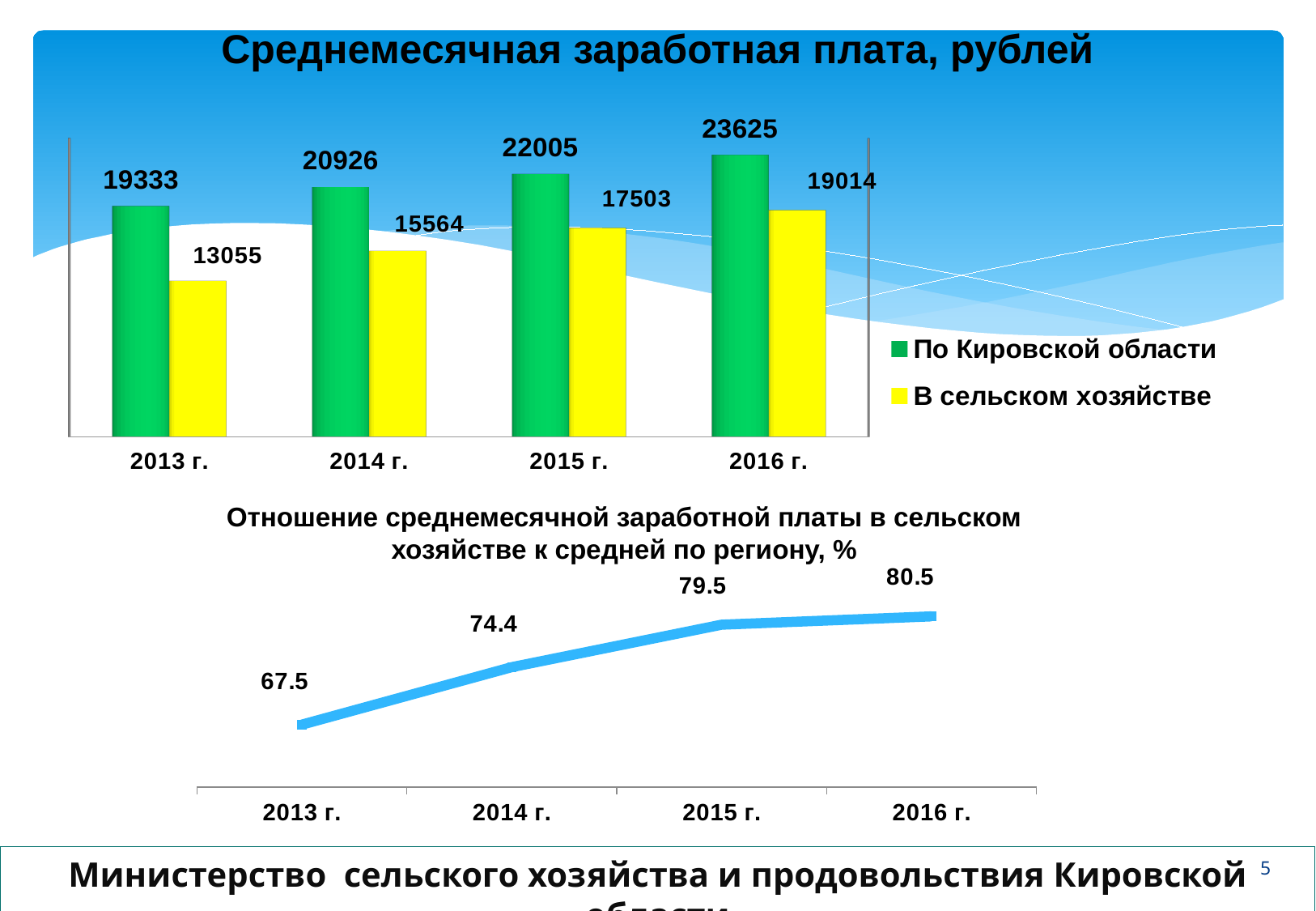
How many series does the legend of the top chart 'Среднемесячная заработная плата, рублей' list? 2 In the top chart 'Среднемесячная заработная плата, рублей', what is the value for 'В сельском хозяйстве' in 2013 г.? 13055 In the top chart 'Среднемесячная заработная плата, рублей', which is larger in 2014 г.: 'По Кировской области' or 'В сельском хозяйстве'? По Кировской области In the top chart 'Среднемесячная заработная плата, рублей', what is the value for 'По Кировской области' in 2015 г.? 22005 What kind of chart is the bottom chart 'Отношение среднемесячной заработной платы в сельском хозяйстве к средней по региону, %'? Line chart In the top chart 'Среднемесячная заработная плата, рублей', which year has the lowest value for 'По Кировской области'? 2013 г. What kind of chart is the top chart 'Среднемесячная заработная плата, рублей'? Bar chart How many data points are plotted in the bottom chart 'Отношение среднемесячной заработной платы в сельском хозяйстве к средней по региону, %'? 4 In the top chart 'Среднемесячная заработная плата, рублей', which year has the highest value for 'В сельском хозяйстве'? 2016 г. In the top chart 'Среднемесячная заработная плата, рублей', what is the difference between 'По Кировской области' and 'В сельском хозяйстве' in 2016 г.? 4611 In the bottom chart 'Отношение среднемесячной заработной платы в сельском хозяйстве к средней по региону, %', what is the value for 2014 г.? 74.4 In the bottom chart 'Отношение среднемесячной заработной платы в сельском хозяйстве к средней по региону, %', do the values rise or fall from 2013 г. to 2016 г.? Rise